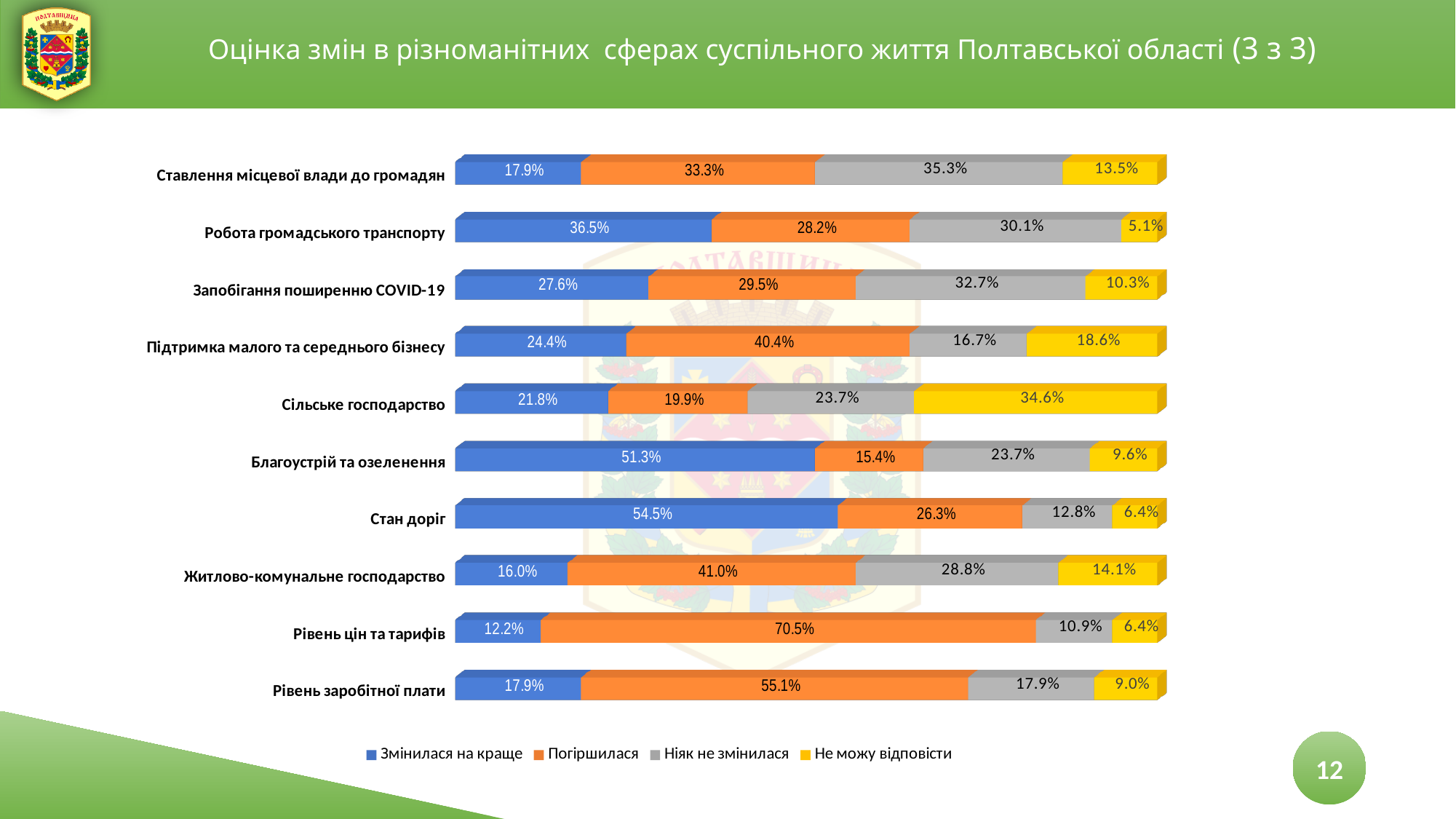
Which category has the lowest value for "Не можу відповісти"? Робота громадського транспорту How many categories (spheres) are shown in the chart? 10 Which category has the highest value for "Змінилася на краще"? Стан доріг What type of chart is shown on the slide? Stacked bar chart What is the difference between "Змінилася на краще" and "Погіршилася" for "Стан доріг"? 28.2% What is the value of "Погіршилася" for "Рівень цін та тарифів"? 70.5% How many series does the legend list? 4 What is the value of "Змінилася на краще" for "Стан доріг"? 54.5% What is the value of "Ніяк не змінилася" for "Ставлення місцевої влади до громадян"? 35.3% What is the value of "Не можу відповісти" for "Сільське господарство"? 34.6% Which category has the highest value for "Погіршилася"? Рівень цін та тарифів Which is larger for "Житлово-комунальне господарство": "Погіршилася" or "Ніяк не змінилася"? Погіршилася